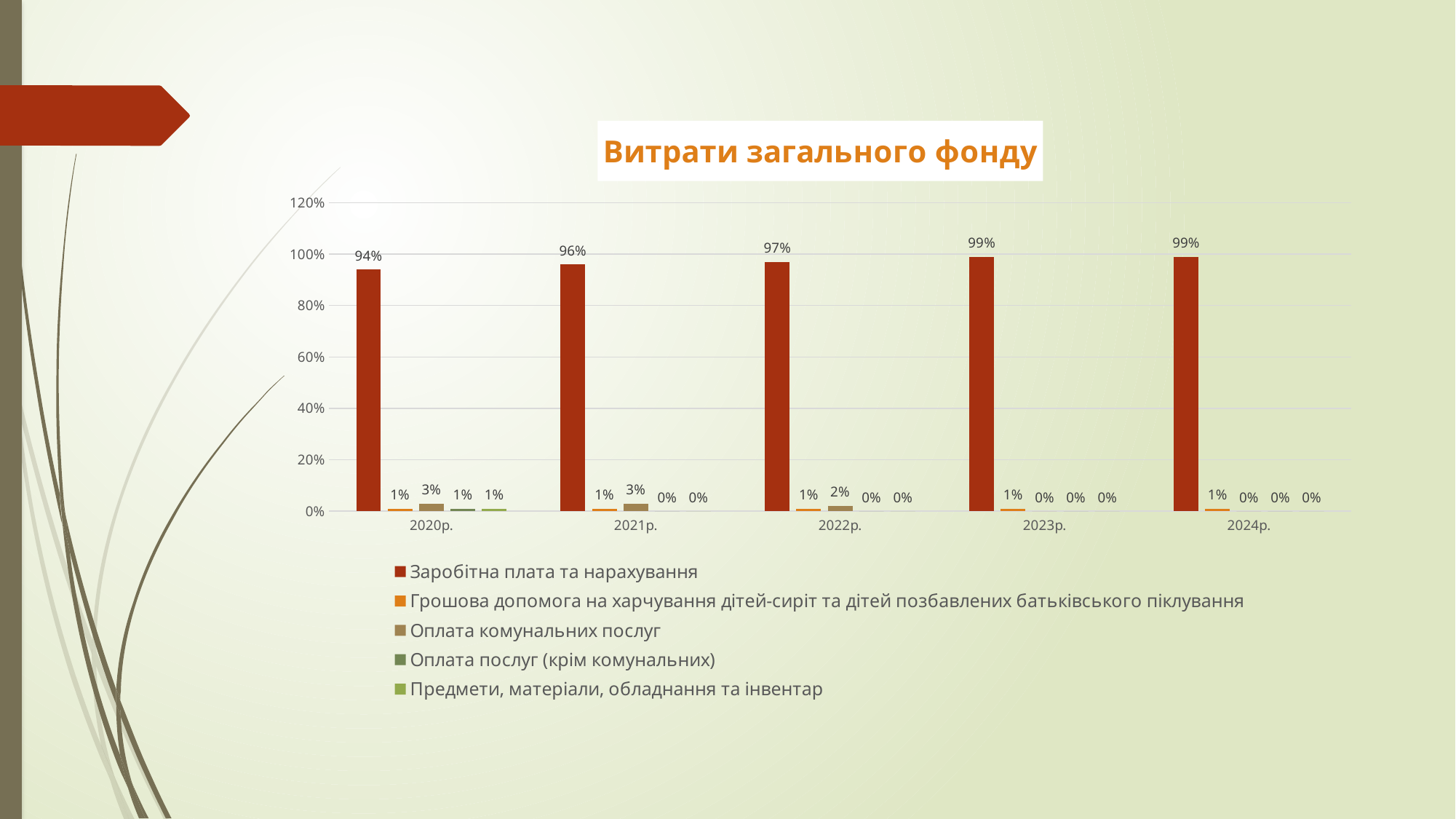
What is the value for Оплата комунальних послуг in 2022р.? 2% What kind of chart is shown on the slide? bar chart What is the value for Оплата комунальних послуг in 2021р.? 3% What is the difference between the Заробітна плата та нарахування values for 2022р. and 2020р.? 3% Does the value for Заробітна плата та нарахування rise or fall from 2020р. to 2023р.? rise How many series does the legend list? 5 Which is larger: Оплата комунальних послуг in 2021р. or in 2022р.? 2021р. What is the value for Заробітна плата та нарахування in 2020р.? 94% What is the value for Заробітна плата та нарахування in 2023р.? 99% How many years are shown on the x axis? 5 In which year is the value for Заробітна плата та нарахування lowest? 2020р. Is the value for Заробітна плата та нарахування in 2021р. greater or less than 80%? greater